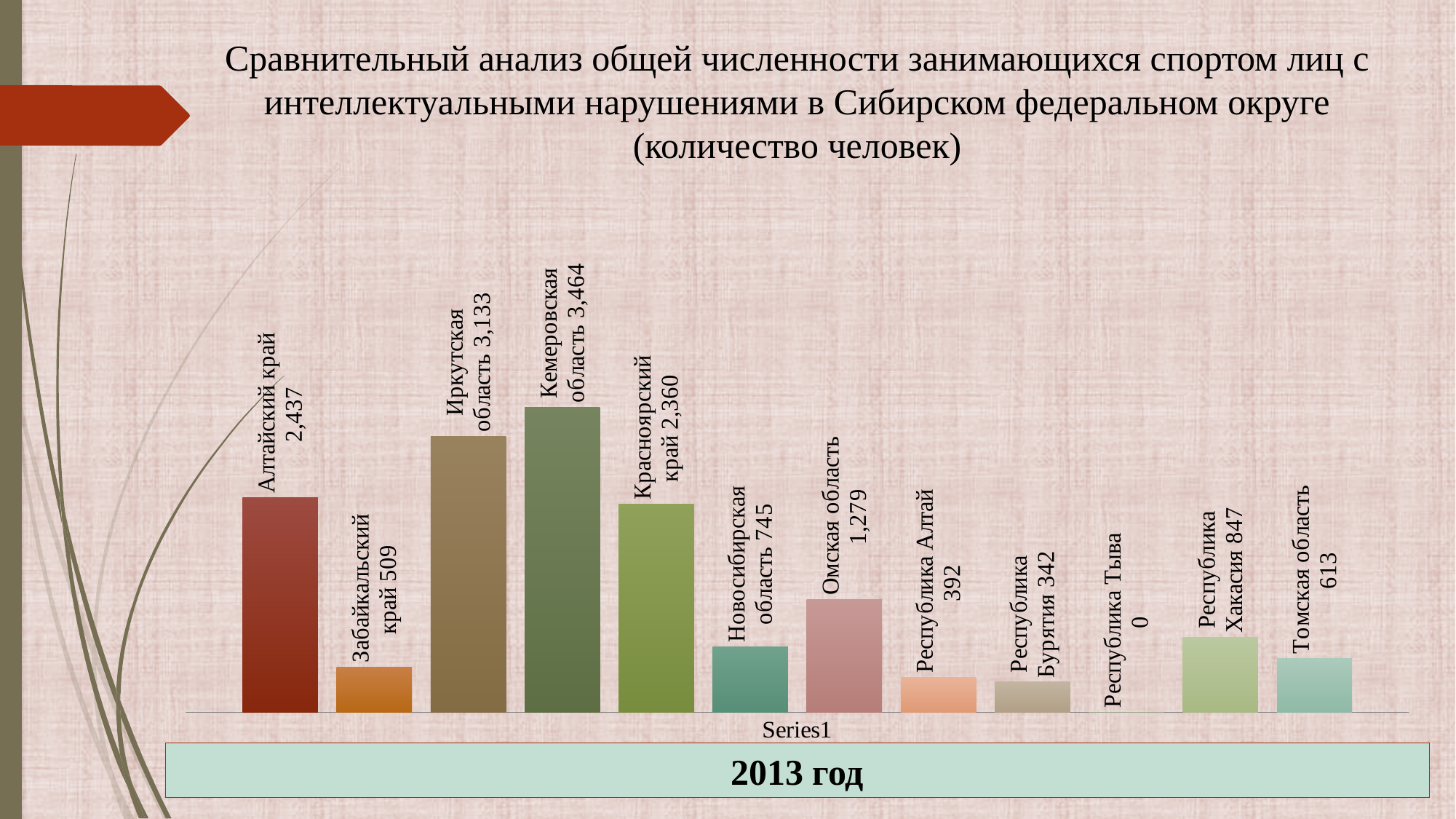
Which region has the lowest value? Республика Тыва What is the value for Омская область? 1,279 Which year does the chart refer to, according to the label below it? 2013 год Which is larger, the value for Новосибирская область or the value for Республика Хакасия? Республика Хакасия What is the difference between the values for Кемеровская область and Иркутская область? 331 How many regions are shown in the chart? 12 What kind of chart is shown on the slide? Bar chart What is the value for Республика Тыва? 0 Which region has the highest value? Кемеровская область What is the value for Кемеровская область? 3,464 What is the difference between the values for Алтайский край and Красноярский край? 77 Which is larger, the value for Забайкальский край or the value for Томская область? Томская область